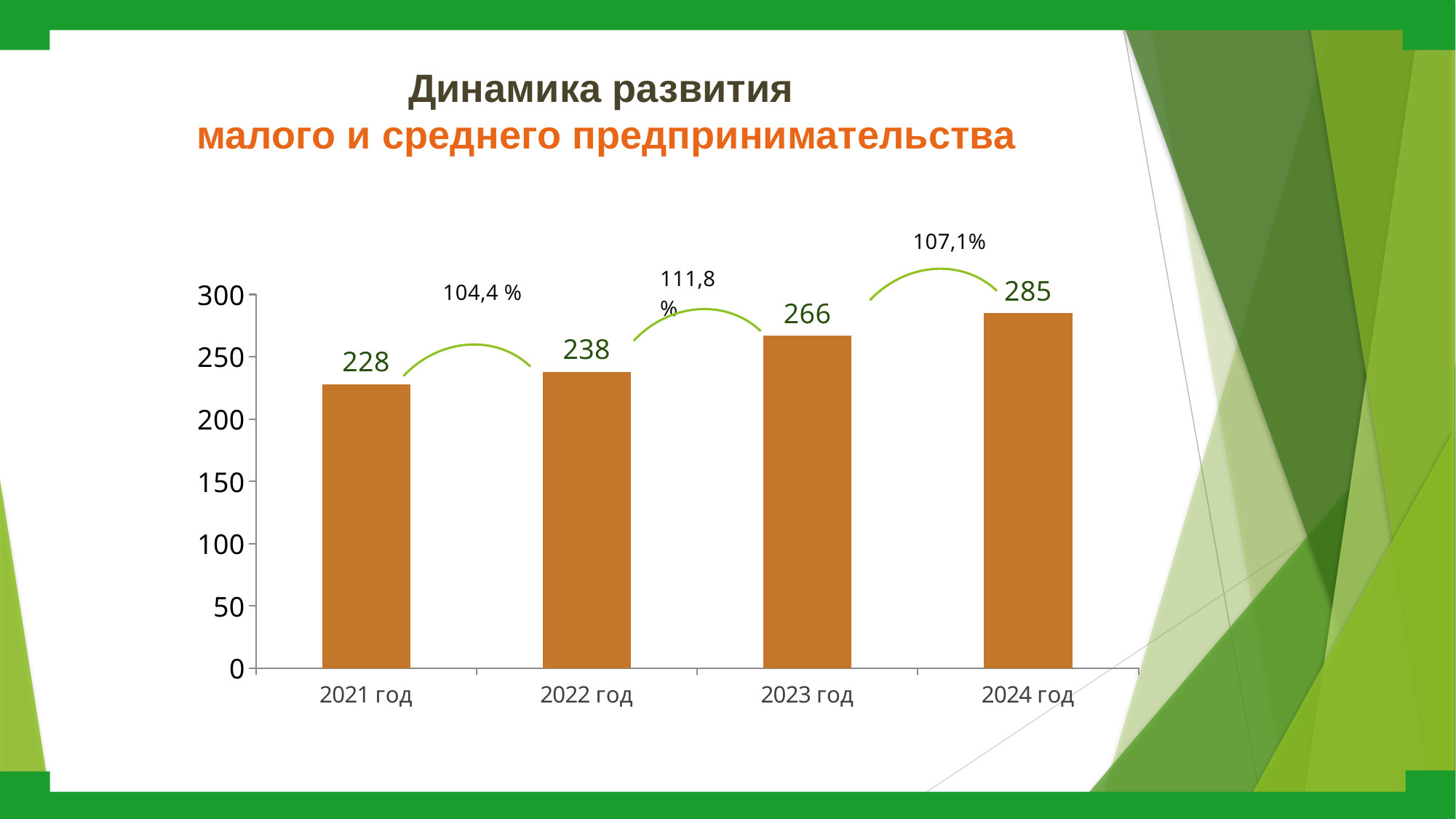
Do the values rise or fall from 2021 год to 2024 год? rise Which is larger, the value for 2022 год or the value for 2023 год? 2023 год What is the value for 2021 год? 228 Which year has the highest value? 2024 год What is the value for 2024 год? 285 What kind of chart is shown on the slide? bar chart How many years are shown on the x axis? 4 What is the value for 2023 год? 266 Is the value for 2024 год greater or less than 250? greater Which year has the lowest value? 2021 год What is the difference between the values for 2024 год and 2021 год? 57 What is the difference between the values for 2023 год and 2022 год? 28